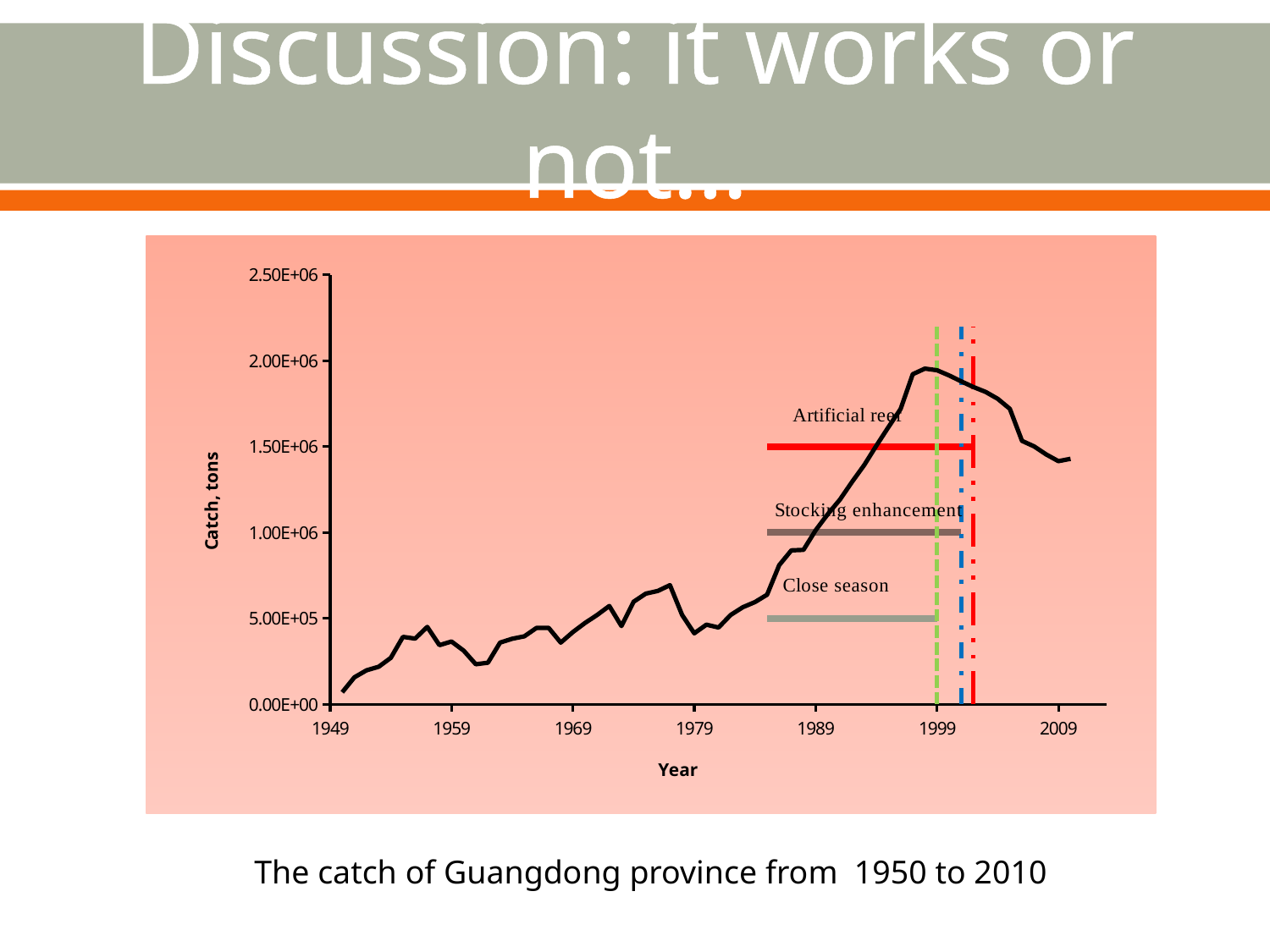
Is the catch value for 1969 greater or less than 5.00E+05? less What is the label of the x axis of the chart? Year Which is larger, the catch in 1989 or the catch in 2009? 2009 Is the catch value for 2009 greater or less than 1.00E+06? greater Is the catch value for 1959 greater or less than 1.00E+06? less Does the catch rise or fall between 1979 and 1999? rise What kind of chart is shown on the slide? line chart What is the label of the y axis of the chart? Catch, tons Does the catch rise or fall between 1999 and 2009? fall Which is larger, the catch in 1959 or the catch in 1999? 1999